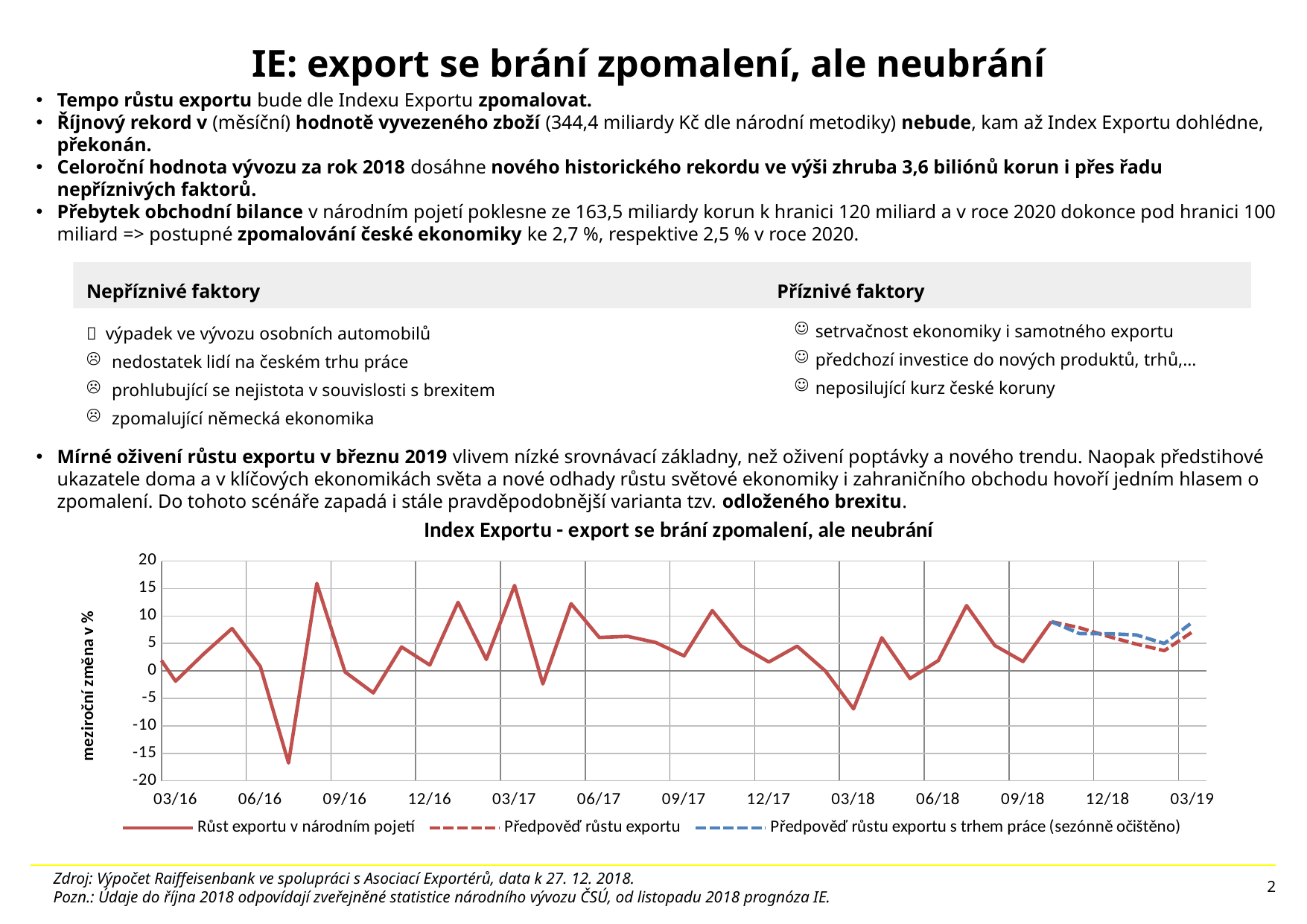
What kind of chart is shown on the slide? line chart How many series does the chart legend list? 3 Is the value of 'Předpověď růstu exportu' at 03/19 greater or less than 5? greater Is the lowest value of the 'Růst exportu v národním pojetí' line greater or less than -15? less At 03/19, which forecast line is higher: 'Předpověď růstu exportu' or 'Předpověď růstu exportu s trhem práce (sezónně očištěno)'? Předpověď růstu exportu s trhem práce (sezónně očištěno) How many date labels are shown on the horizontal axis of the chart? 13 Is the value of 'Růst exportu v národním pojetí' at 03/18 greater or less than -5? less What is the title of the chart? Index Exportu - export se brání zpomalení, ale neubrání What is the label of the vertical axis of the chart? meziroční změna v % Which is higher for 'Růst exportu v národním pojetí': the value at 03/17 or the value at 03/18? 03/17